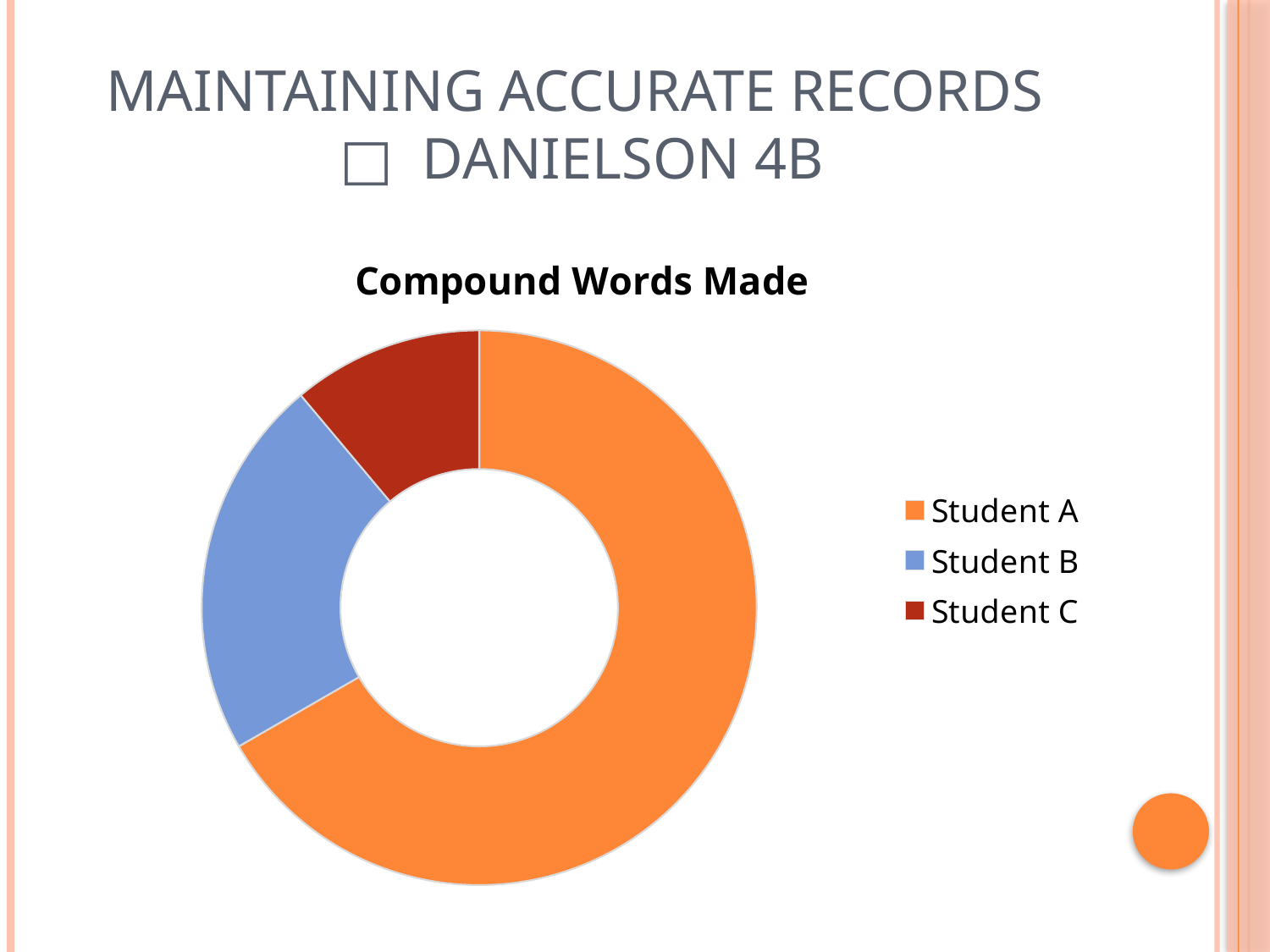
How many categories does the chart show? 3 What kind of chart is shown on the slide? Doughnut chart Is the share for Student C greater or less than 25%? less Which colour represents Student B in the chart? Blue Is the share for Student A greater or less than 50%? greater Which is larger, the share for Student B or the share for Student C? Student B Which student has the smallest share of compound words made? Student C Which student has the largest share of compound words made? Student A Which is larger, the share for Student A or the share for Student B? Student A What is the title of the chart? Compound Words Made